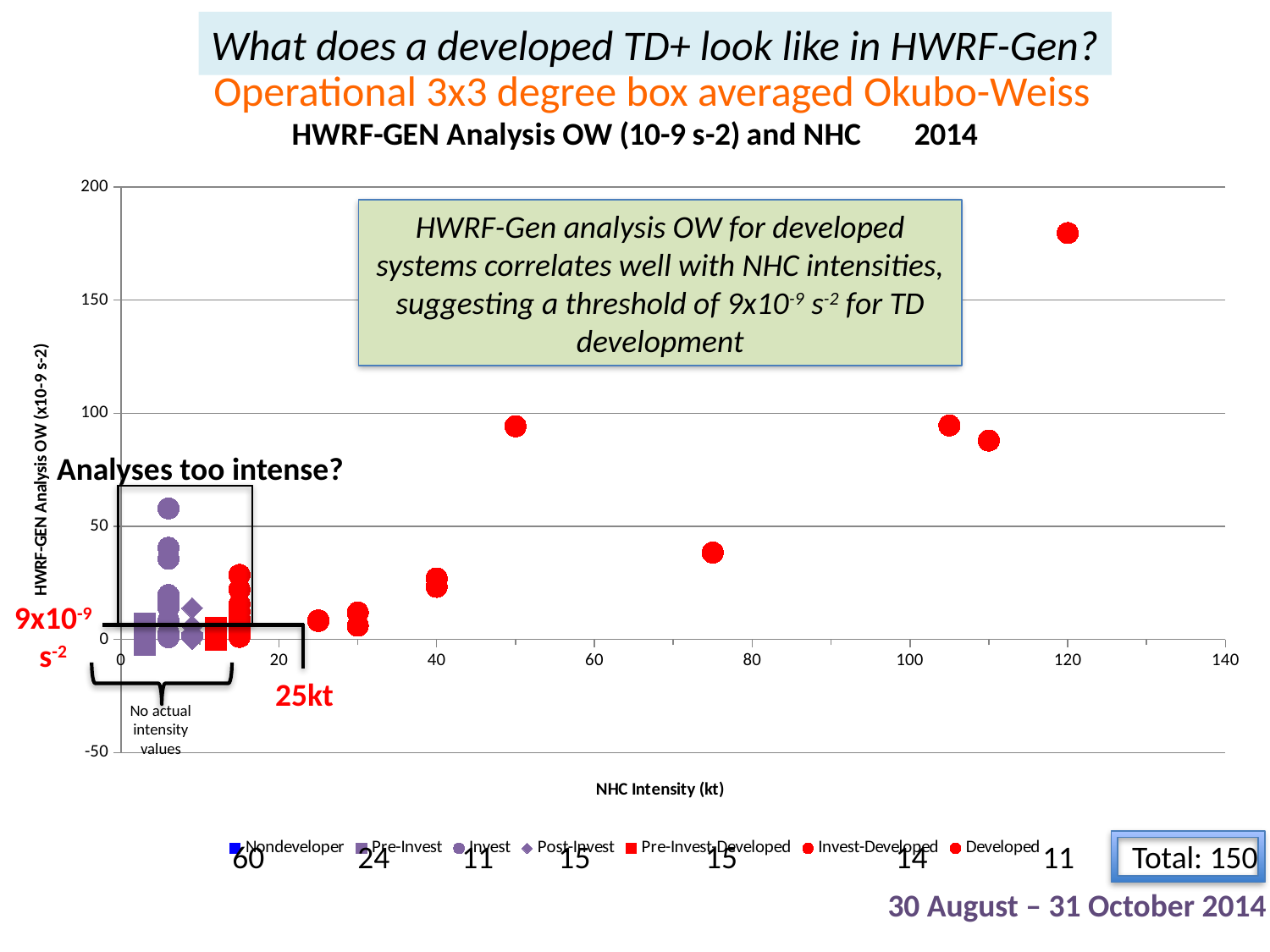
At which NHC intensity (kt) does the point with the highest HWRF-GEN Analysis OW value occur? 120 Do the HWRF-GEN Analysis OW values for developed systems generally rise or fall as NHC intensity increases? rise Is the HWRF-GEN Analysis OW value for the point at NHC intensity 75 kt greater or less than 50? less How many series does the chart legend list? 7 Is the HWRF-GEN Analysis OW value for the point at NHC intensity 50 kt greater or less than 50? greater What total number of cases is shown below the chart legend? 150 What is the label of the x axis of the chart? NHC Intensity (kt) Is the HWRF-GEN Analysis OW value for the point at NHC intensity 110 kt greater or less than 100? less What is the title of the chart? HWRF-GEN Analysis OW (10-9 s-2) and NHC 2014 Which has the higher HWRF-GEN Analysis OW value: the point at NHC intensity 120 kt or the point at 75 kt? 120 kt What kind of chart is shown on the slide? Scatter chart